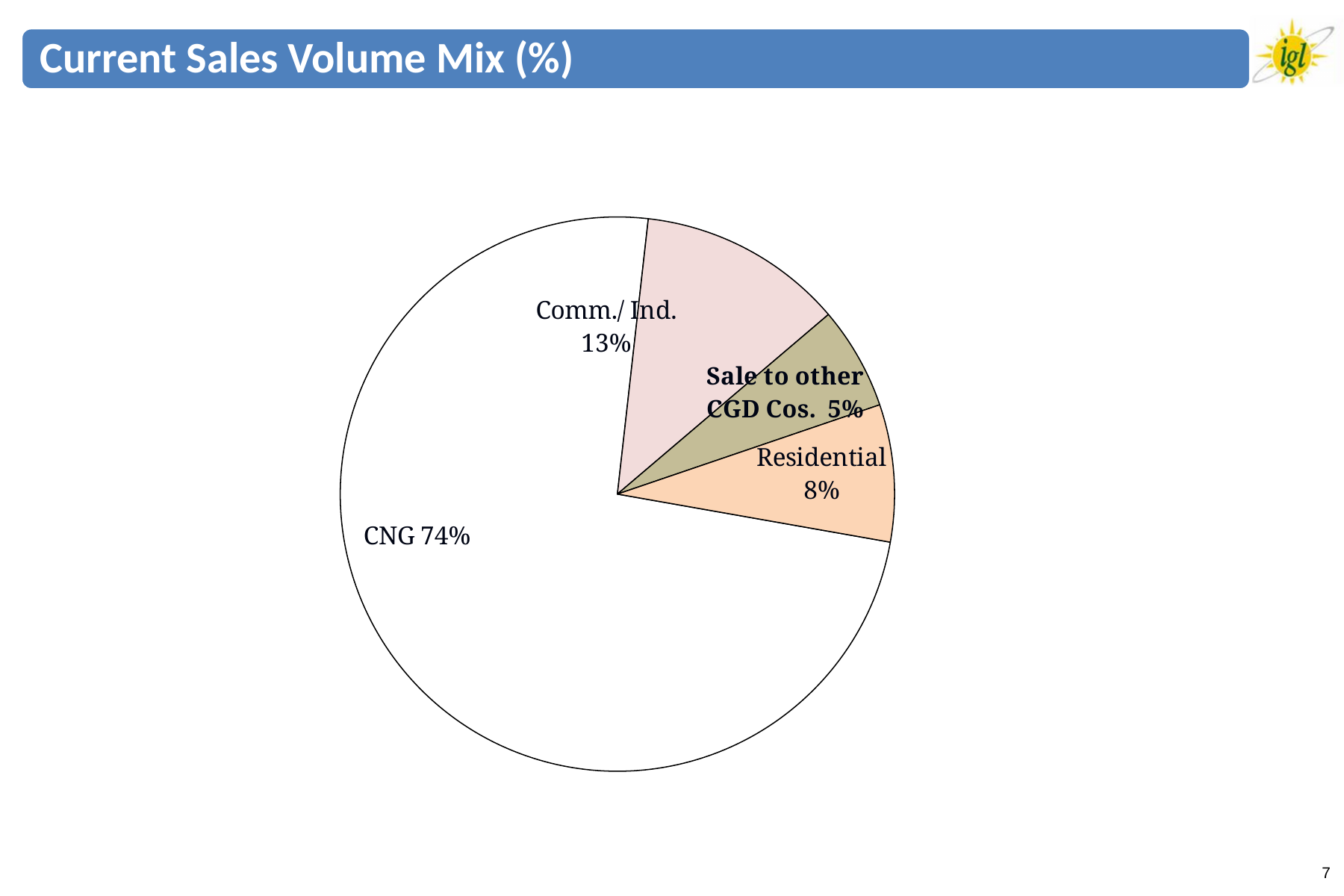
What is the difference in percentage points between the CNG share and the Comm./ Ind. share? 61 Which segment has the smallest share of the sales volume mix? Sale to other CGD Cos. What share of the sales volume mix is Sale to other CGD Cos.? 5% What share of the sales volume mix is Residential? 8% How many slices does the pie chart have? 4 What share of the sales volume mix is CNG? 74% What is the combined share of Residential and Sale to other CGD Cos.? 13% Which is larger, the Residential share or the Comm./ Ind. share? Comm./ Ind. Which segment has the largest share of the sales volume mix? CNG What share of the sales volume mix is Comm./ Ind.? 13% What type of chart is shown on the slide? pie chart What is the title of the slide containing the pie chart? Current Sales Volume Mix (%)